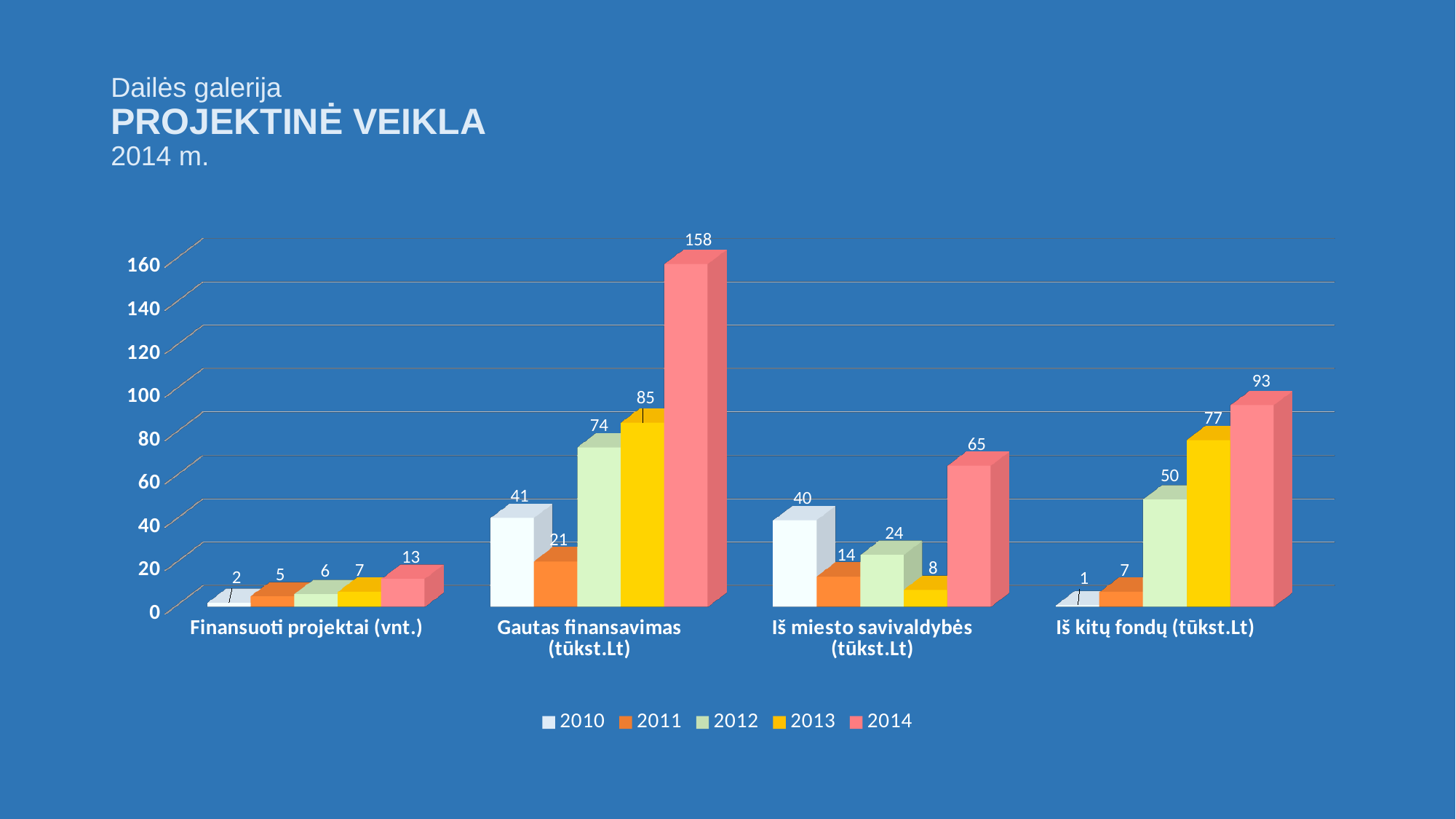
How many categories are shown on the x axis? 4 What is the value for 2014 in the 'Gautas finansavimas (tūkst.Lt)' category? 158 How many series does the legend list? 5 Is the 2014 value for 'Iš kitų fondų (tūkst.Lt)' greater or less than 80? greater What is the difference between the 2014 and 2013 values in the 'Gautas finansavimas (tūkst.Lt)' category? 73 What is the value for 2011 in the 'Iš miesto savivaldybės (tūkst.Lt)' category? 14 Which year has the highest value in the 'Finansuoti projektai (vnt.)' category? 2014 What is the value for 2013 in the 'Iš kitų fondų (tūkst.Lt)' category? 77 In the 'Iš miesto savivaldybės (tūkst.Lt)' category, which is larger: the 2010 value or the 2012 value? 2010 Which year has the lowest value in the 'Iš kitų fondų (tūkst.Lt)' category? 2010 What kind of chart is shown on the slide? Bar chart Do the values in the 'Finansuoti projektai (vnt.)' category rise or fall from 2010 to 2014? Rise